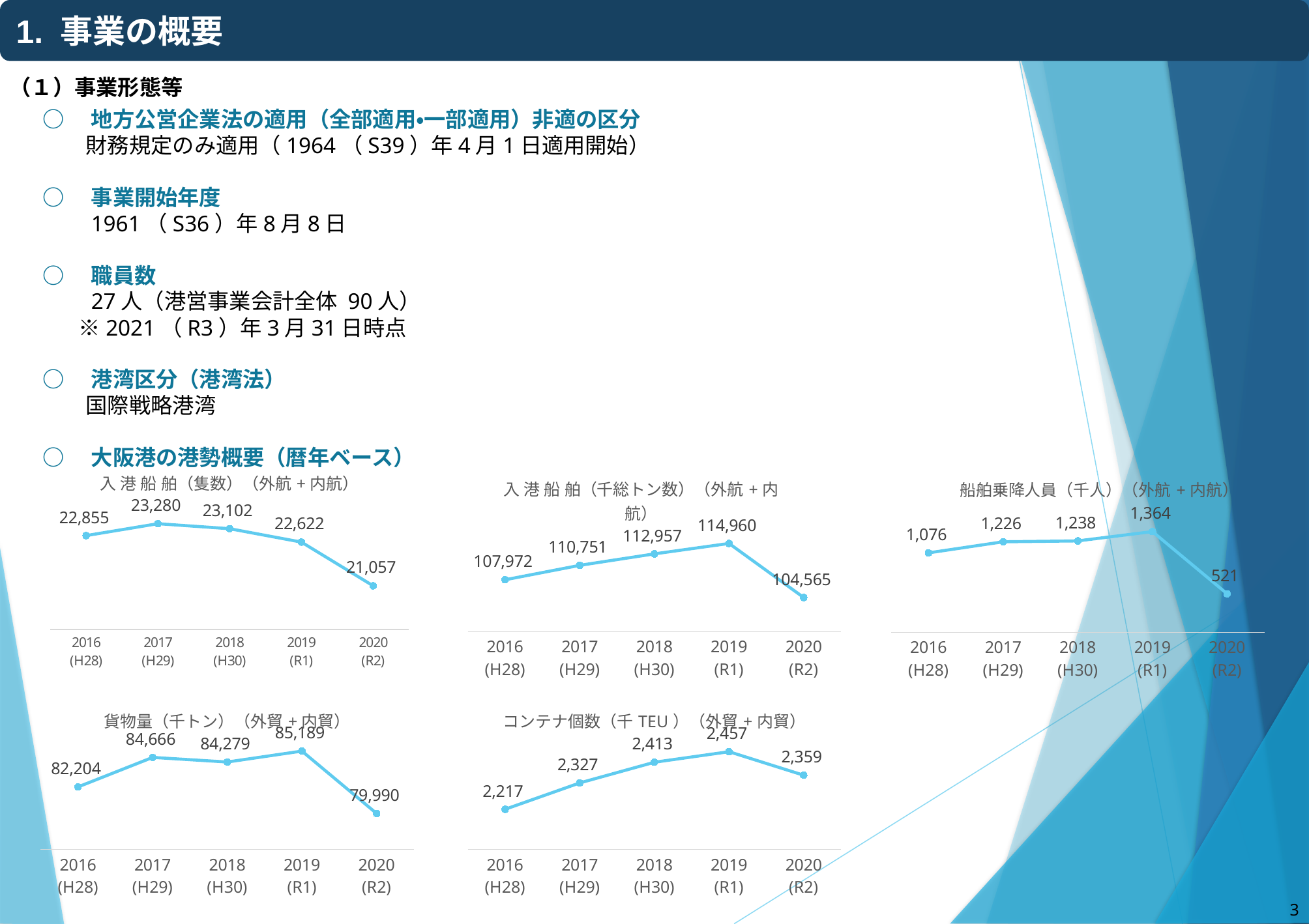
In the 船舶乗降人員（千人） chart, what is the difference between the 2019 (R1) and 2020 (R2) values? 843 In the 入港船舶（千総トン数） chart, which year has the lowest value? 2020 (R2) In the コンテナ個数（千TEU） chart, what is the value for 2018 (H30)? 2,413 In the 船舶乗降人員（千人） chart, what is the value for 2020 (R2)? 521 In the 入港船舶（千総トン数） chart, what is the value for 2019 (R1)? 114,960 In the コンテナ個数（千TEU） chart, is the value for 2019 (R1) larger or smaller than the value for 2020 (R2)? larger What type of chart is the 貨物量（千トン） chart? line chart In the 入港船舶（隻数） chart, what is the value for 2020 (R2)? 21,057 In the 貨物量（千トン） chart, what is the value for 2016 (H28)? 82,204 In the 貨物量（千トン） chart, which year has the highest value? 2019 (R1) How many data points does the コンテナ個数（千TEU） chart show? 5 In the 入港船舶（隻数） chart, which year has the highest value? 2017 (H29)